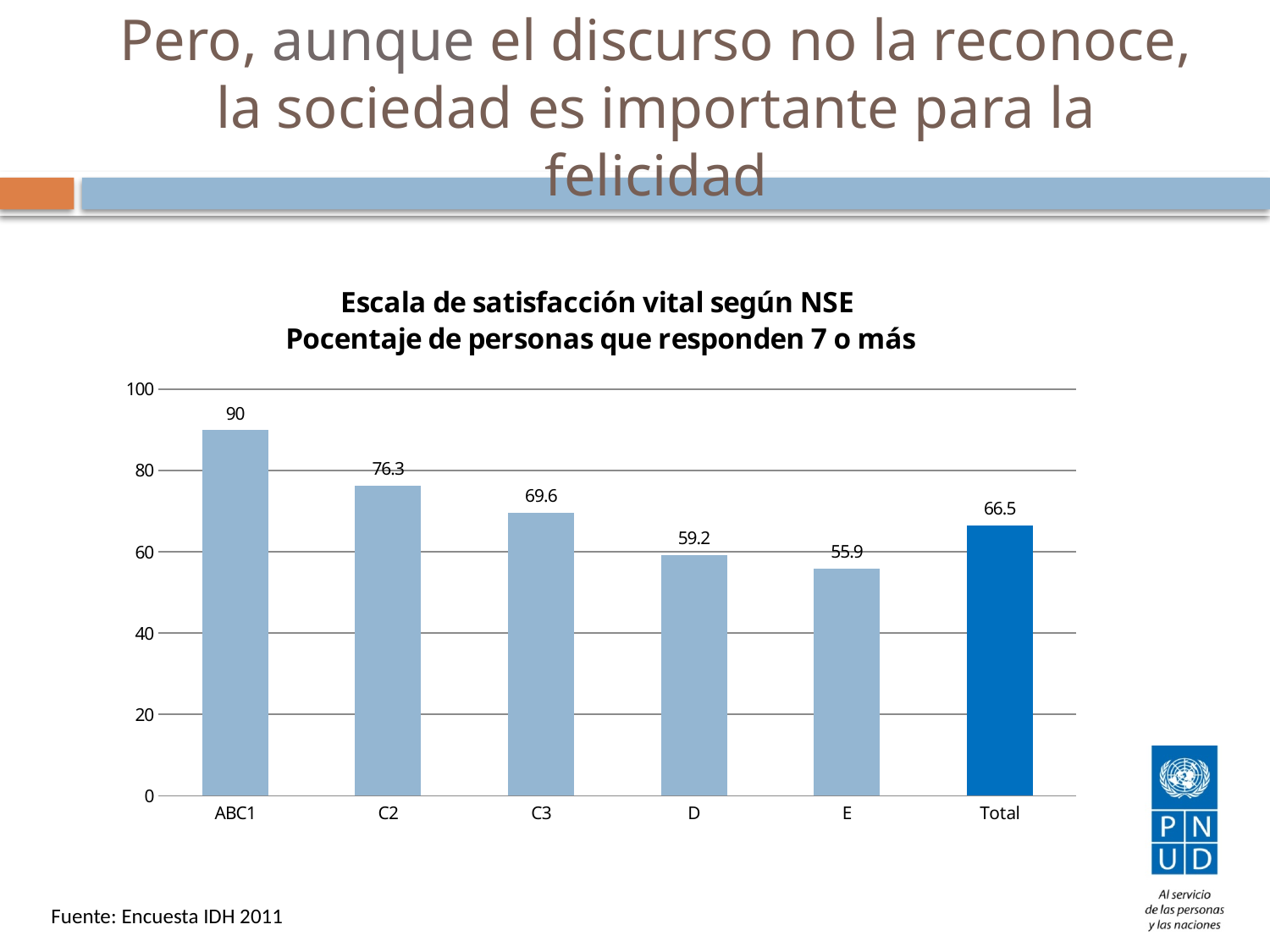
What is the value for Total? 66.5 Is the value for C2 greater or less than 80? less What is the difference between the values for C2 and D? 17.1 What kind of chart is shown on the slide? bar chart Which category has the highest value? ABC1 Do the values rise or fall from ABC1 to E? fall What is the difference between the values for ABC1 and E? 34.1 What is the value for ABC1? 90 Which is larger, the value for D or the value for Total? Total How many categories are shown on the x axis? 6 Which category has the lowest value? E What is the value for C3? 69.6